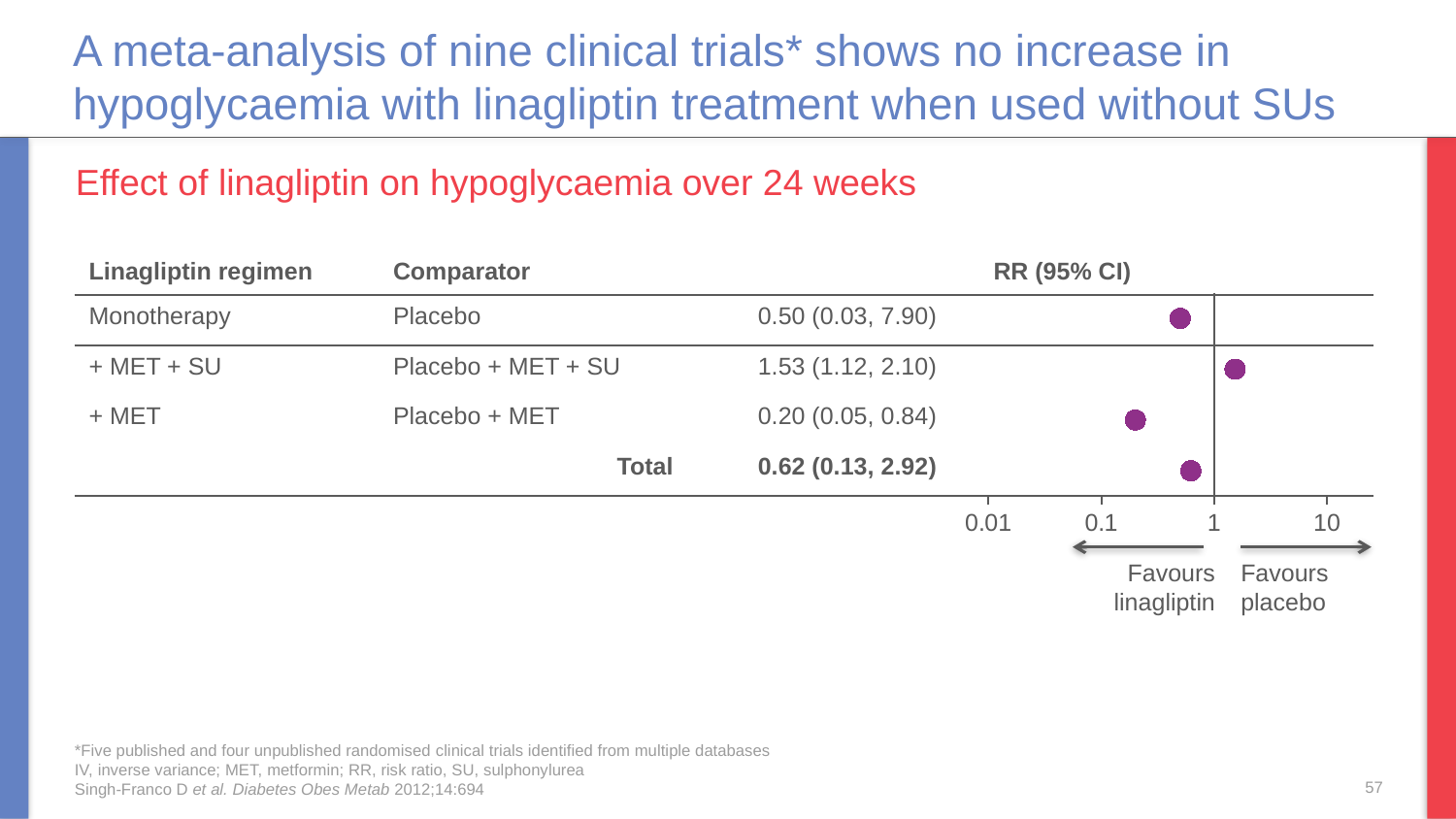
What does the right-hand side of the x axis (values above 1) favour, according to the axis label? Favours placebo What is the RR (95% CI) for the + MET + SU regimen? 1.53 (1.12, 2.10) What kind of chart is shown on the slide? Forest plot What is the RR (95% CI) for the + MET regimen versus Placebo + MET? 0.20 (0.05, 0.84) Which has the larger risk ratio, Monotherapy or + MET? Monotherapy What is the RR (95% CI) for the Monotherapy regimen versus Placebo? 0.50 (0.03, 7.90) Is the risk ratio for + MET + SU greater or less than 1? greater How many rows of risk ratios, including the Total, are plotted in the forest plot? 4 What is the Total RR (95% CI) shown in the forest plot? 0.62 (0.13, 2.92) What is the difference between the risk ratio for + MET + SU and the risk ratio for Monotherapy? 1.03 Which linagliptin regimen has the highest risk ratio? + MET + SU Which linagliptin regimen has the lowest risk ratio? + MET